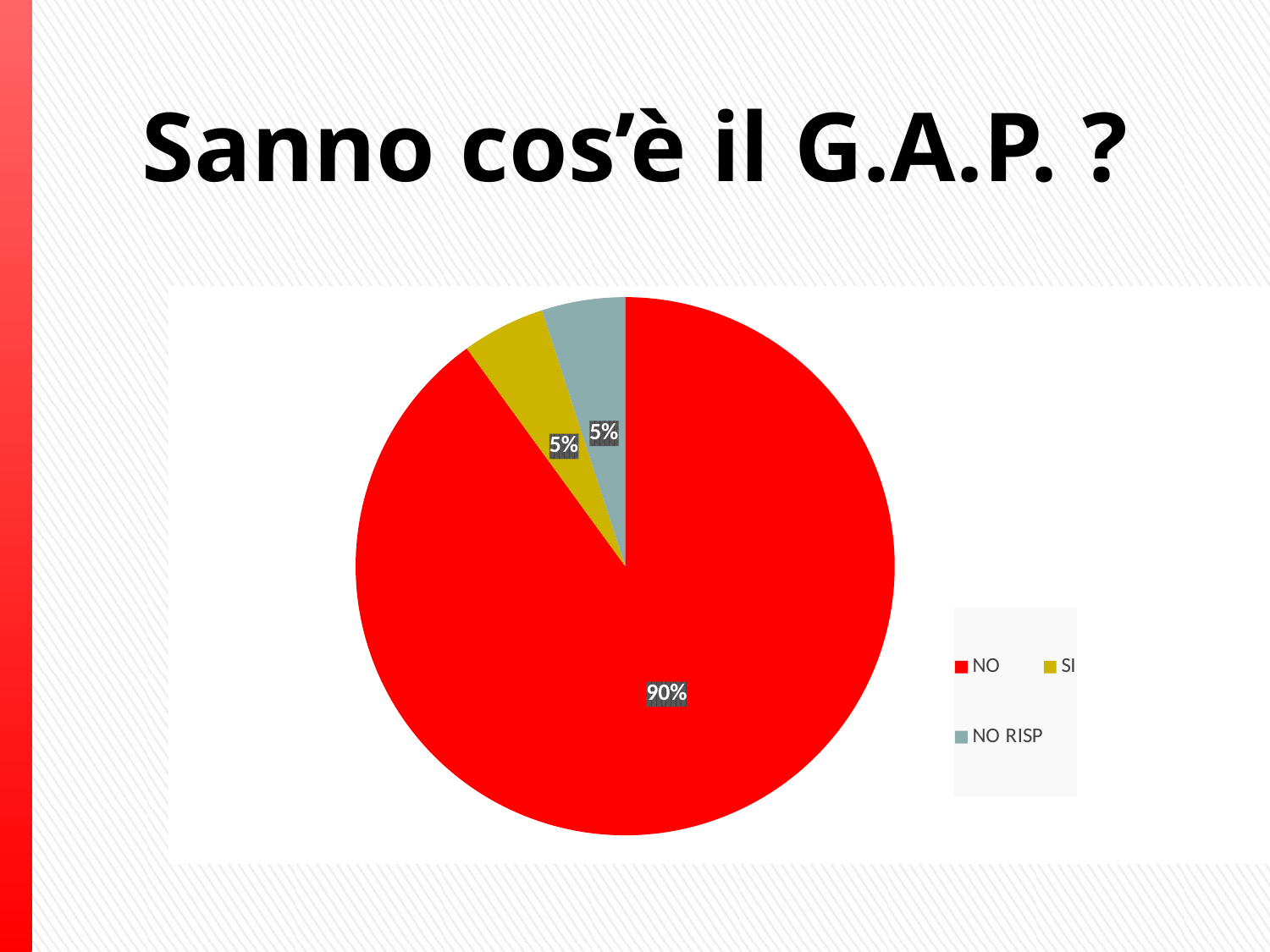
What percentage of the pie is labelled NO? 90% Which is larger, the NO slice or the NO RISP slice? NO What percentage of the pie is labelled SI? 5% What is the combined share of the SI and NO RISP slices? 10% What type of chart is shown on the slide? pie chart How many entries does the legend list? 3 What colour is the NO slice in the pie chart? red What percentage of the pie is labelled NO RISP? 5% How many slices does the pie chart have? 3 What is the difference in percentage points between the NO slice and the SI slice? 85 Which category has the largest slice of the pie? NO What is the title of the slide containing the pie chart? Sanno cos'è il G.A.P. ?